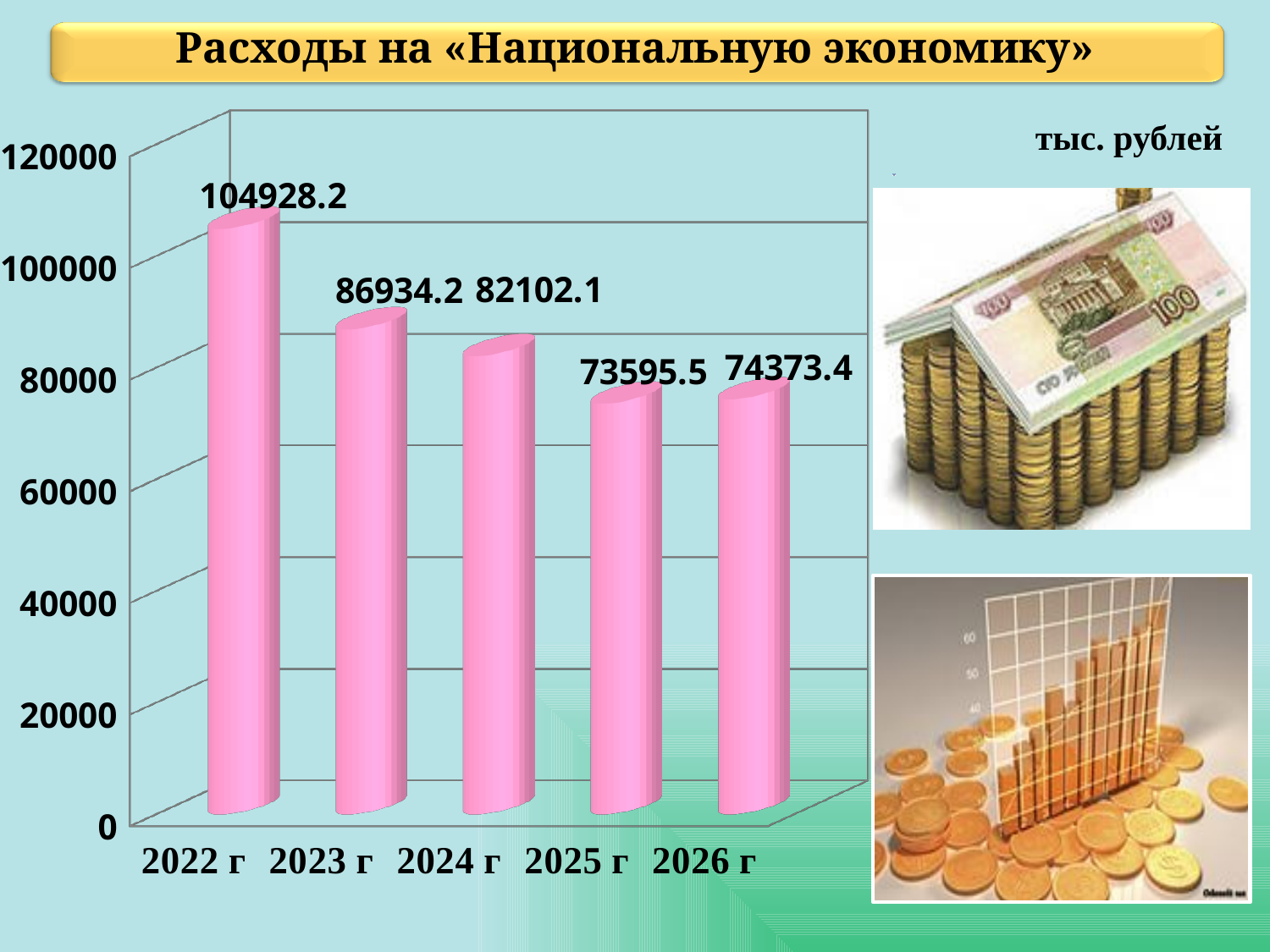
What kind of chart is shown on the slide? bar chart How many years are shown on the chart? 5 Which is larger, the value for 2025 г or the value for 2026 г? 2026 г Which year has the highest value? 2022 г What is the difference between the values for 2026 г and 2025 г? 777.9 What is the value for 2022 г? 104928.2 Is the value for 2023 г greater or less than 80000? greater Which year has the lowest value? 2025 г What is the value for 2026 г? 74373.4 What is the value for 2024 г? 82102.1 What is the difference between the values for 2022 г and 2023 г? 17994.0 Do the values generally rise or fall from 2022 г to 2025 г? fall